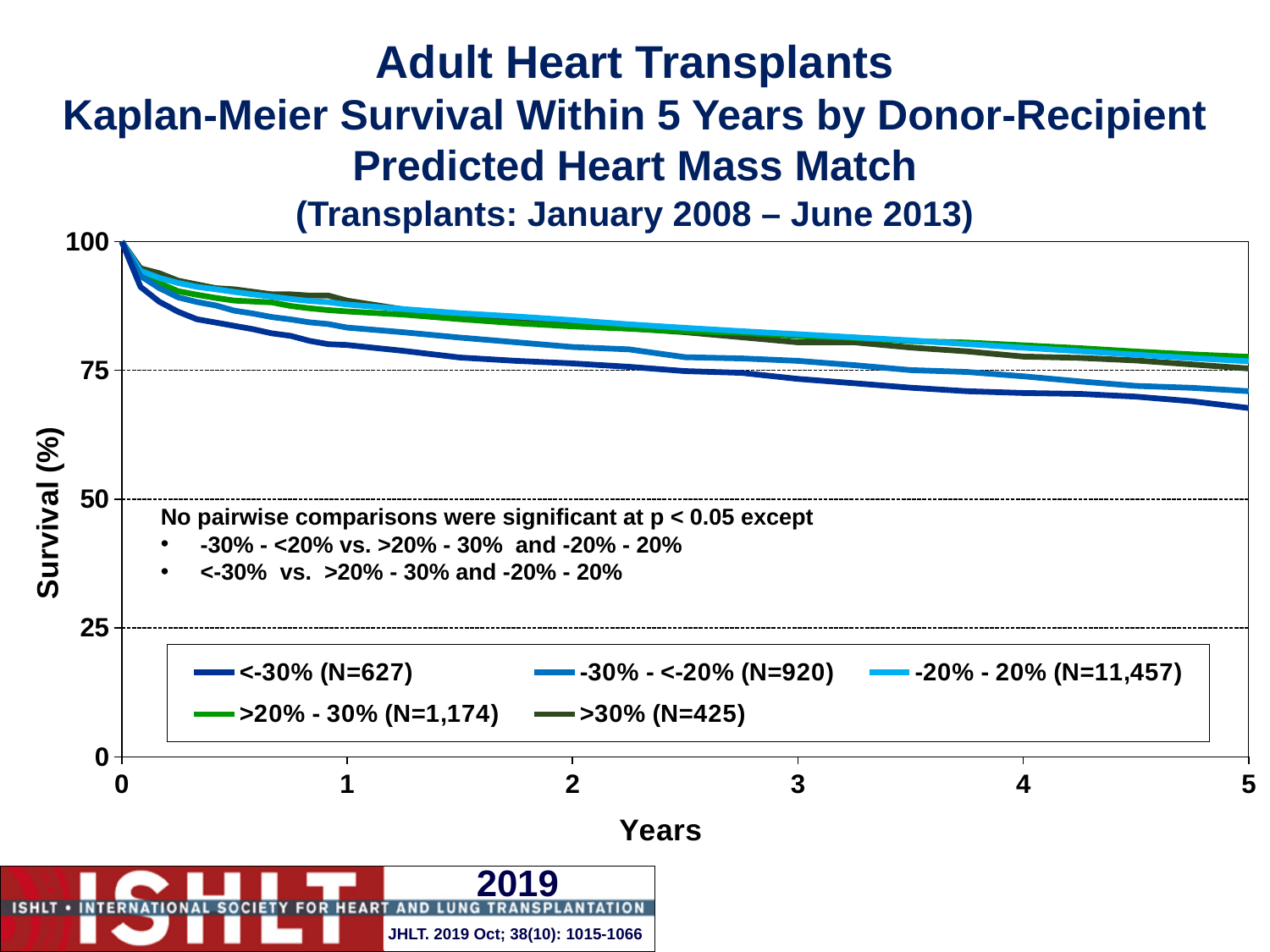
Is the survival value for the -20% - 20% group at 1 year greater or less than 75? greater According to the legend, what is the N for the <-30% group? 627 What kind of chart is shown on the slide? line chart Is the survival value for the -30% - <-20% group at 5 years greater or less than 50? greater Which group has the lowest survival at 5 years? <-30% (N=627) How many series does the legend list? 5 Is the survival value for the <-30% group at 1 year greater or less than 75? greater Do the survival curves rise or fall as years increase? fall According to the legend, what is the N for the -20% - 20% group? 11,457 At 5 years, which has higher survival: the <-30% group or the -30% - <-20% group? -30% - <-20% (N=920)